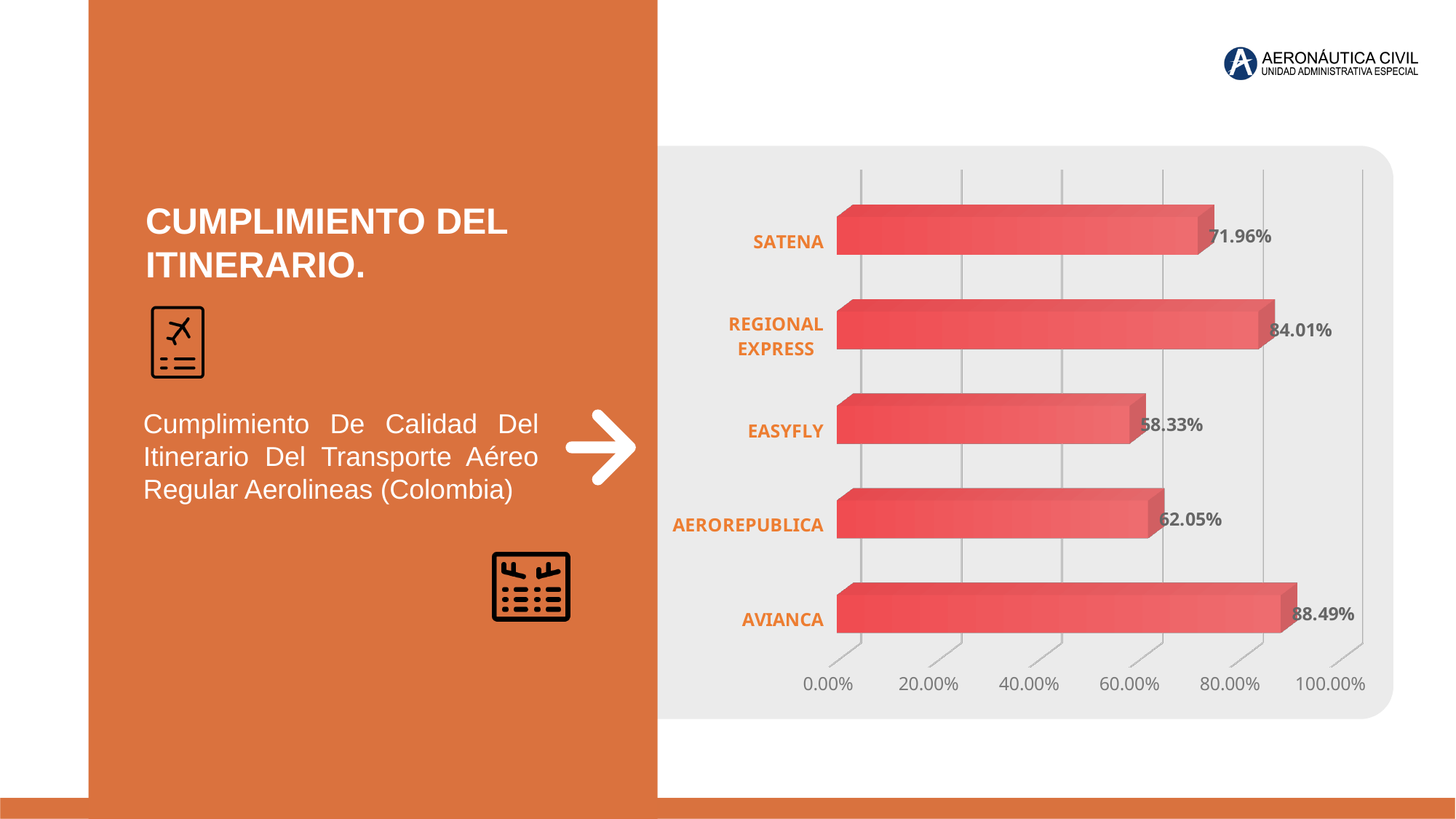
Which airline has the lowest value? EASYFLY What is the difference between the values for AVIANCA and EASYFLY? 30.16% What is the value for SATENA? 71.96% Is the value for REGIONAL EXPRESS greater or less than 80.00%? greater What is the value for REGIONAL EXPRESS? 84.01% Which airline has the highest value? AVIANCA What is the value for EASYFLY? 58.33% Which is larger, the value for SATENA or the value for AEROREPUBLICA? SATENA What is the value for AVIANCA? 88.49% What is the value for AEROREPUBLICA? 62.05% What kind of chart is shown on the slide? bar chart How many airlines are shown in the chart? 5